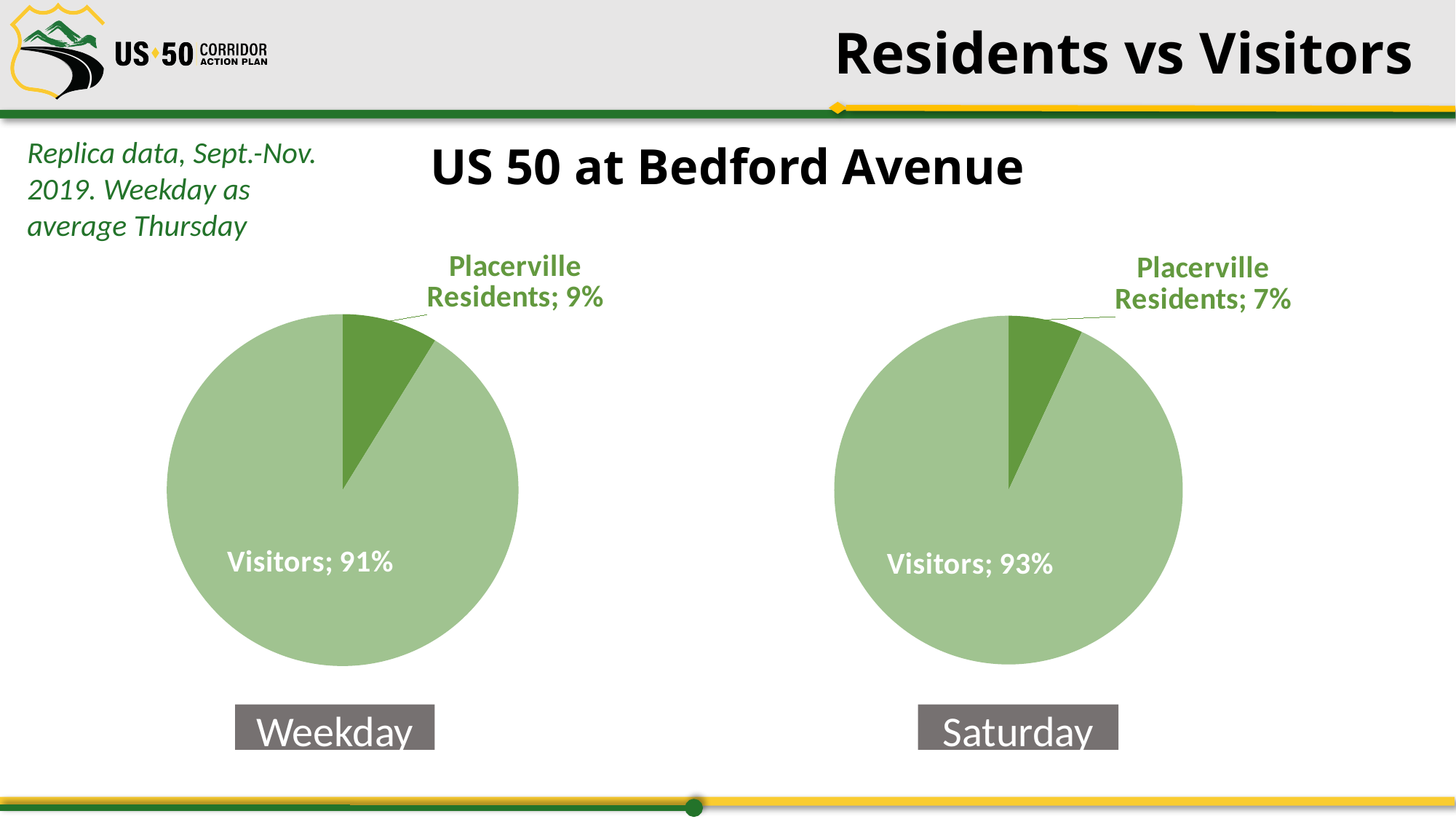
What kind of chart is used for the Saturday data? Pie chart In the Weekday pie chart, what share of the pie is Placerville Residents? 9% In the Saturday pie chart, what share of the pie is Visitors? 93% In the Saturday pie chart, which slice is the smallest? Placerville Residents How many slices does the Weekday pie chart have? 2 In the Weekday pie chart, what share of the pie is Visitors? 91% What is the title shown above the two pie charts? US 50 at Bedford Avenue Is the Visitors share larger in the Weekday chart or the Saturday chart? Saturday In the Weekday pie chart, which slice is the largest? Visitors How many pie charts are shown on the slide? 2 What is the difference between the Placerville Residents share in the Weekday chart and in the Saturday chart? 2%